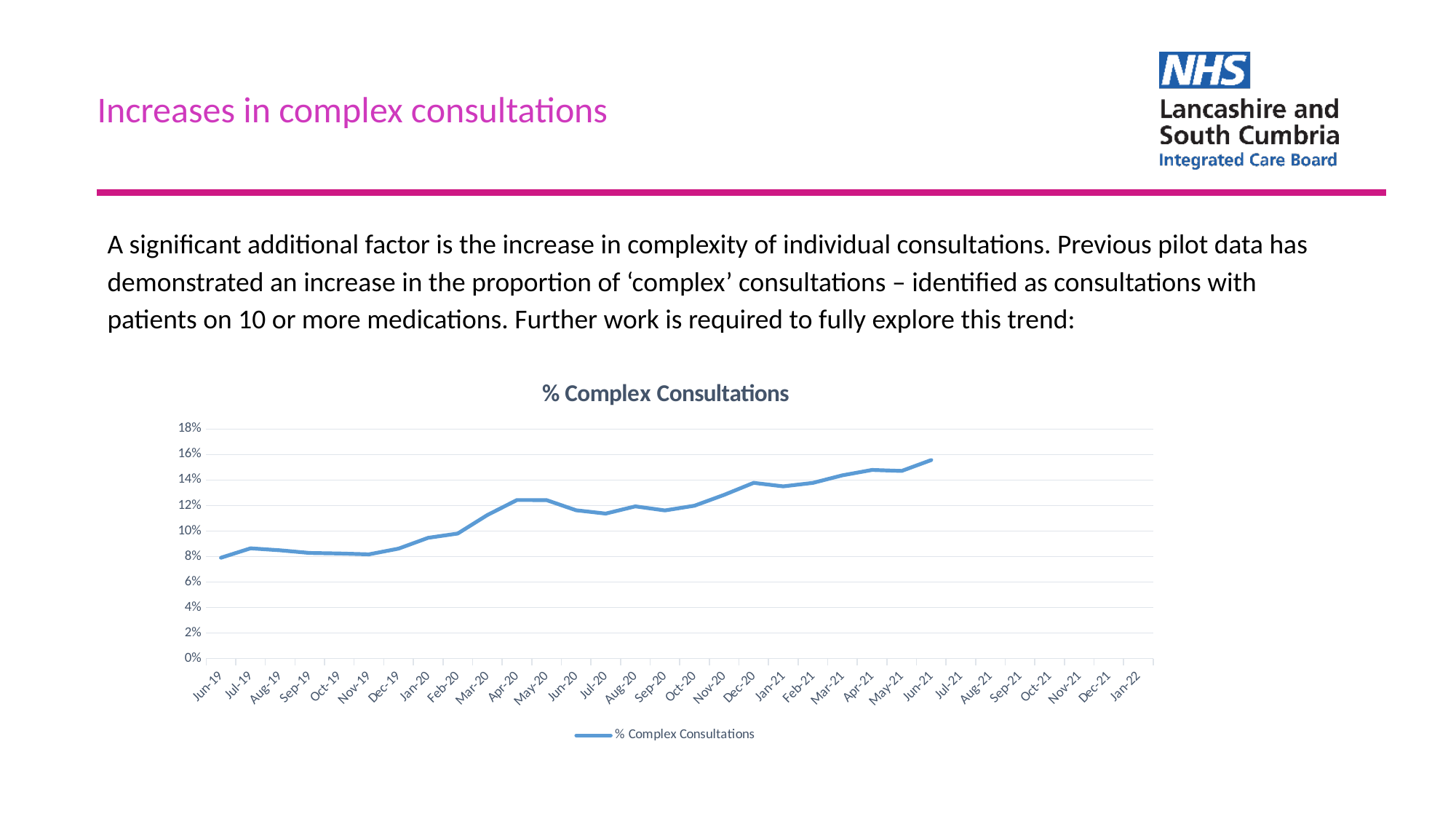
What is the title of the chart? % Complex Consultations What is the highest value shown on the vertical axis? 18% How many series does the chart legend list? 1 What kind of chart is shown on the slide? line chart Which month has the lowest % Complex Consultations value? Jun-19 Is the value for Jul-20 greater or less than 12%? less Is the value for Jun-21 greater or less than 14%? greater Which is larger, the value for Apr-20 or the value for Jul-20? Apr-20 Is the value for Jun-19 greater or less than 10%? less Which month has the highest % Complex Consultations value? Jun-21 Does the % Complex Consultations line generally rise or fall from Jun-19 to Jun-21? rise